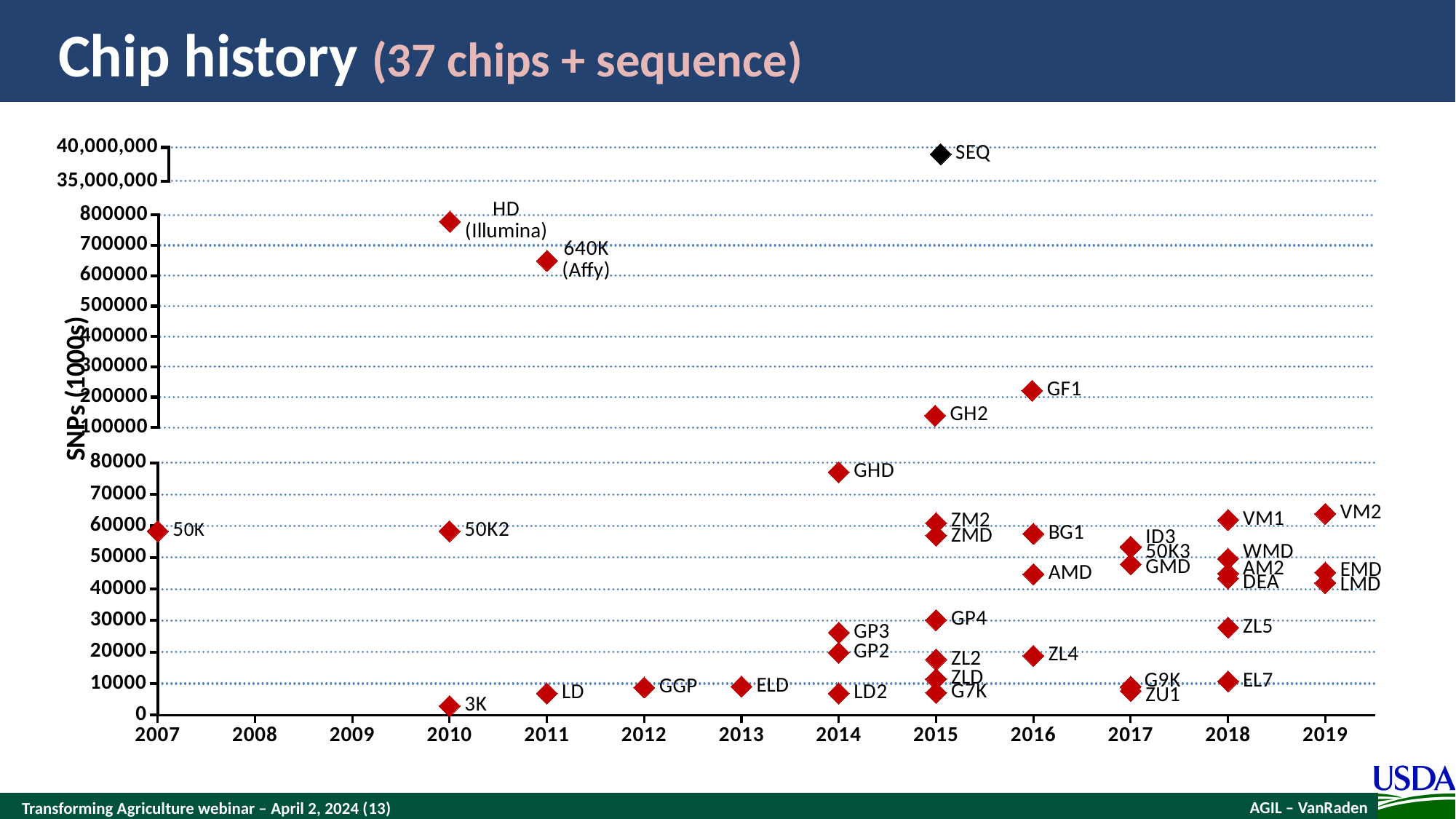
Is the value for GF1 greater or less than 200000? greater How many years are labelled on the x axis? 13 Which point has the lowest SNPs value? 3K In which year is the 50K chip plotted? 2007 Is the value for 3K greater or less than 10000? less Which has a higher SNPs value, HD (Illumina) or 640K (Affy)? HD (Illumina) What kind of chart is shown on the slide? scatter chart Which point has the highest SNPs value? SEQ Which has a higher SNPs value, VM2 or LMD? VM2 Is the value for GHD greater or less than 70000? greater In which year is the GGP chip plotted? 2012 What is the title of the y axis? SNPs (1000s)